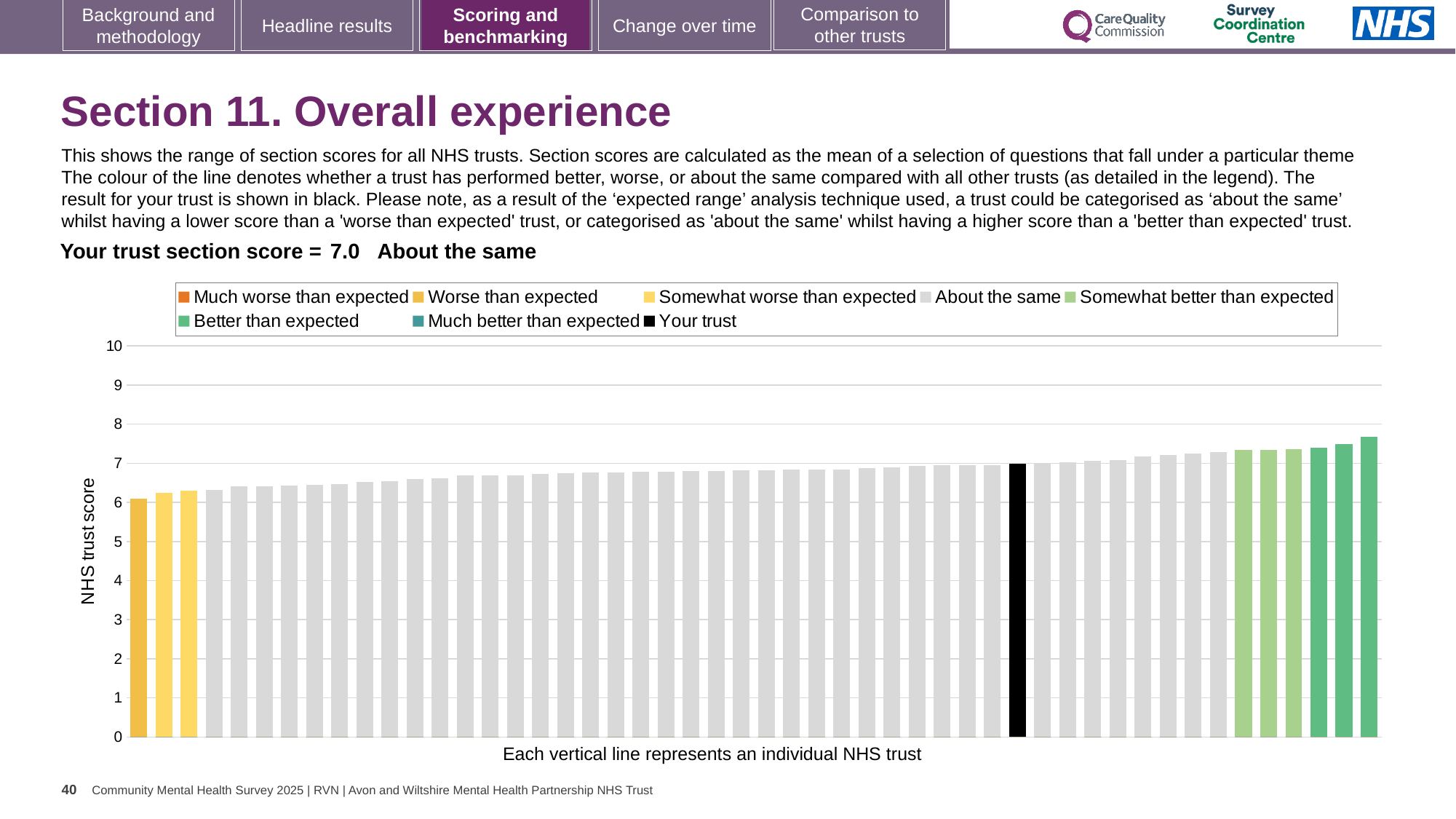
Do the bar values rise or fall from left to right along the x axis? Rise How many entries does the chart legend list? 8 Is the value of the leftmost (lowest) bar greater or less than 7? less What is the label on the vertical axis of the chart? NHS trust score What is the section score for your trust shown on the slide? 7.0 Which category is your trust placed in for this section? About the same Is the value of the rightmost bar greater or less than 8? less What colour is used for the 'Your trust' bar in the chart? Black What kind of chart is shown on the slide? Bar chart Is the value of the rightmost (highest) bar greater or less than 7? greater Which is larger, the leftmost bar or the rightmost bar? The rightmost bar Which is larger, the black 'Your trust' bar or the leftmost orange bar? The black 'Your trust' bar